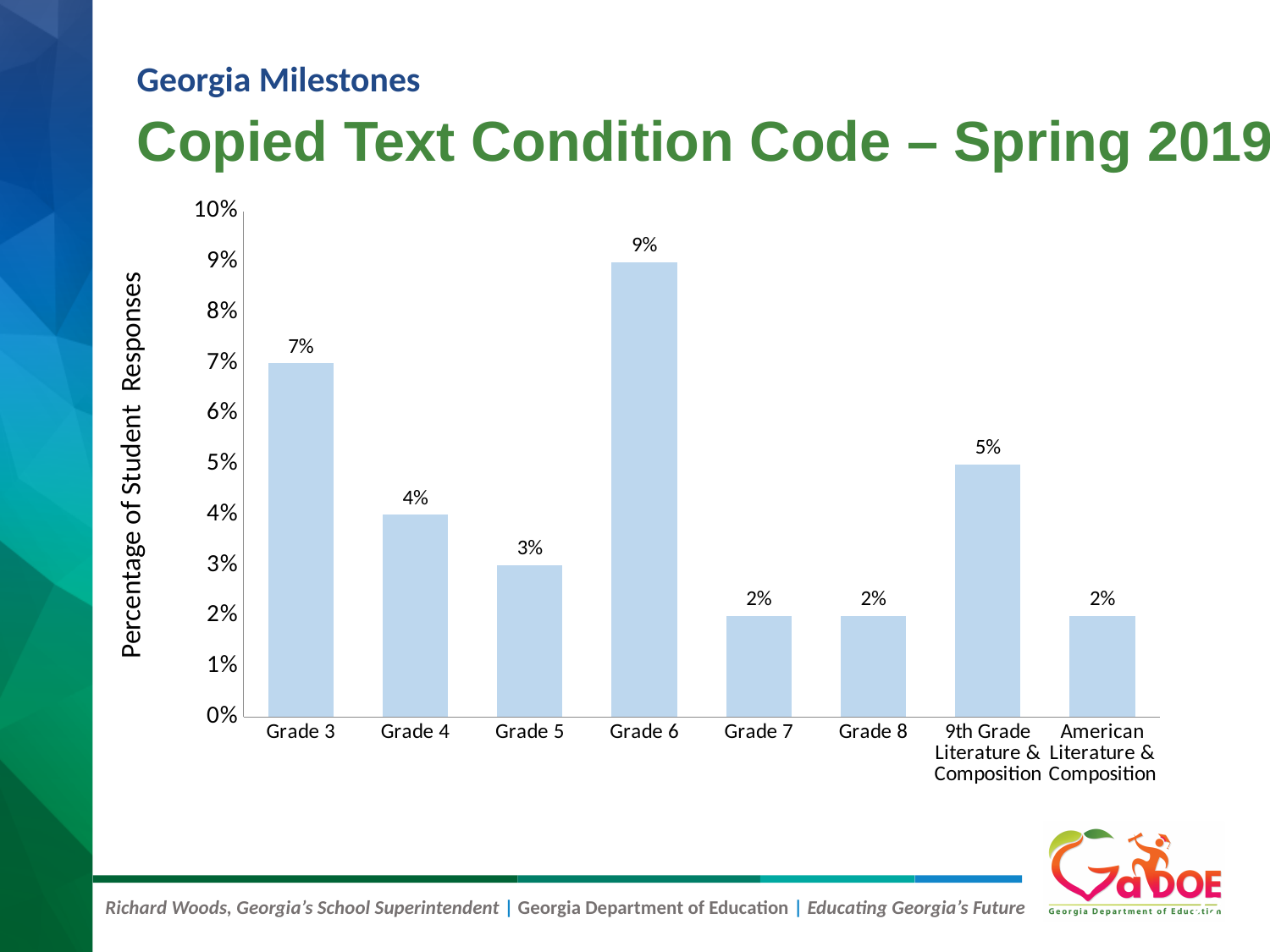
What kind of chart is shown on the slide? bar chart What is the value for Grade 5? 3% What is the difference between the values for Grade 6 and Grade 3? 2% How many categories are shown on the x axis? 8 What is the value for 9th Grade Literature & Composition? 5% Which is larger, the value for Grade 4 or the value for 9th Grade Literature & Composition? 9th Grade Literature & Composition What is the value for Grade 3? 7% Is the value for Grade 3 greater or less than 5%? greater Which category has the highest value? Grade 6 What is the value for Grade 6? 9% What is the difference between the values for Grade 4 and Grade 7? 2% What is the label of the vertical axis? Percentage of Student Responses